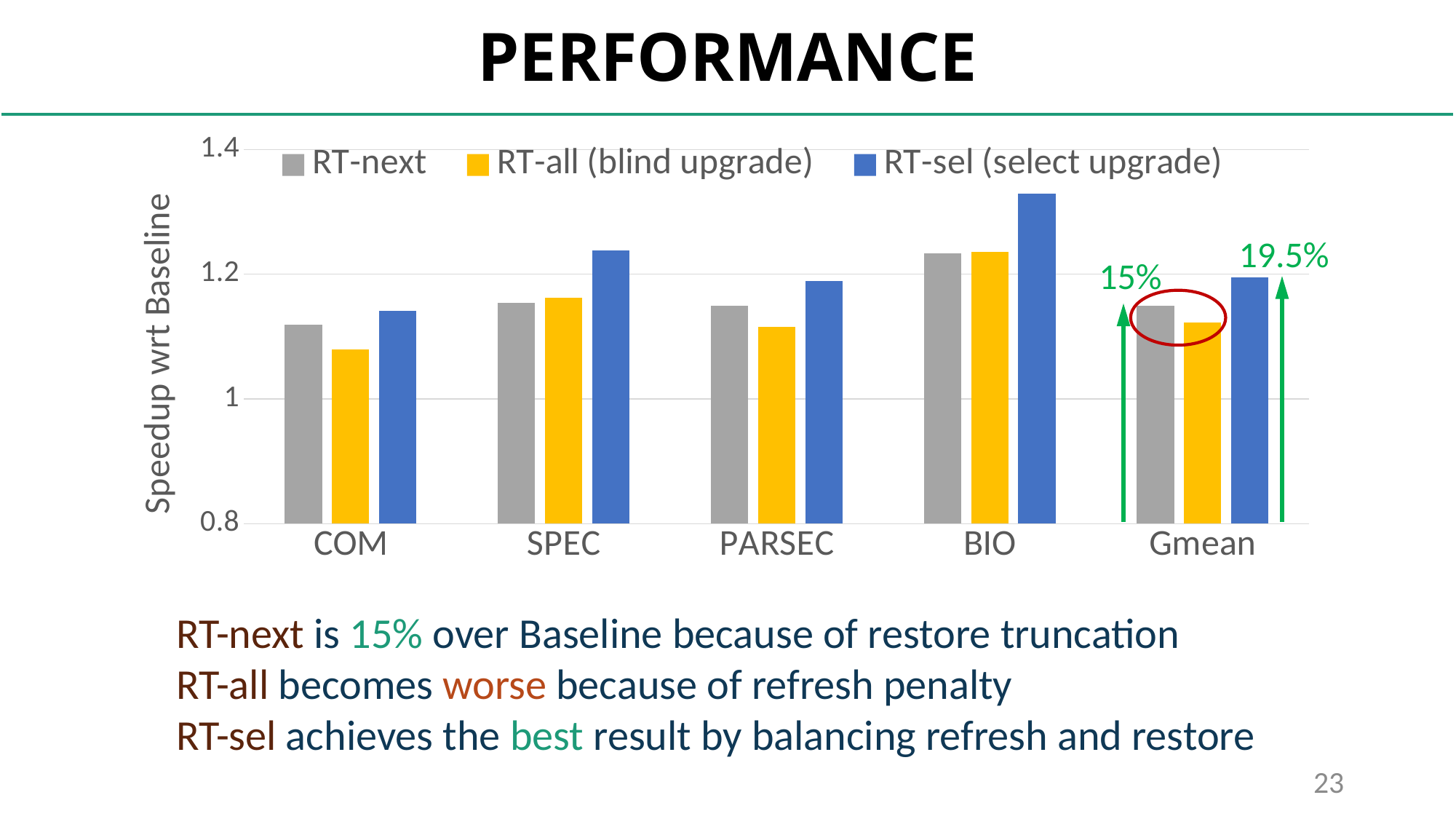
How many categories are shown on the x axis of the chart? 5 Which category has the highest RT-sel (select upgrade) bar? BIO How many series does the chart's legend list? 3 Is the RT-all (blind upgrade) value for COM greater or less than 1.2? less What percentage improvement is annotated above the RT-sel (select upgrade) bar for Gmean? 19.5% Is the RT-sel (select upgrade) value for BIO greater or less than 1.2? greater Which category has the lowest RT-all (blind upgrade) bar? COM What is the label of the y axis of the chart? Speedup wrt Baseline Is the RT-all (blind upgrade) value for PARSEC greater or less than 1? greater Which series is shown in yellow in the chart? RT-all (blind upgrade) What kind of chart is shown on the slide? bar chart For COM, which is larger: the RT-all (blind upgrade) bar or the RT-sel (select upgrade) bar? RT-sel (select upgrade)